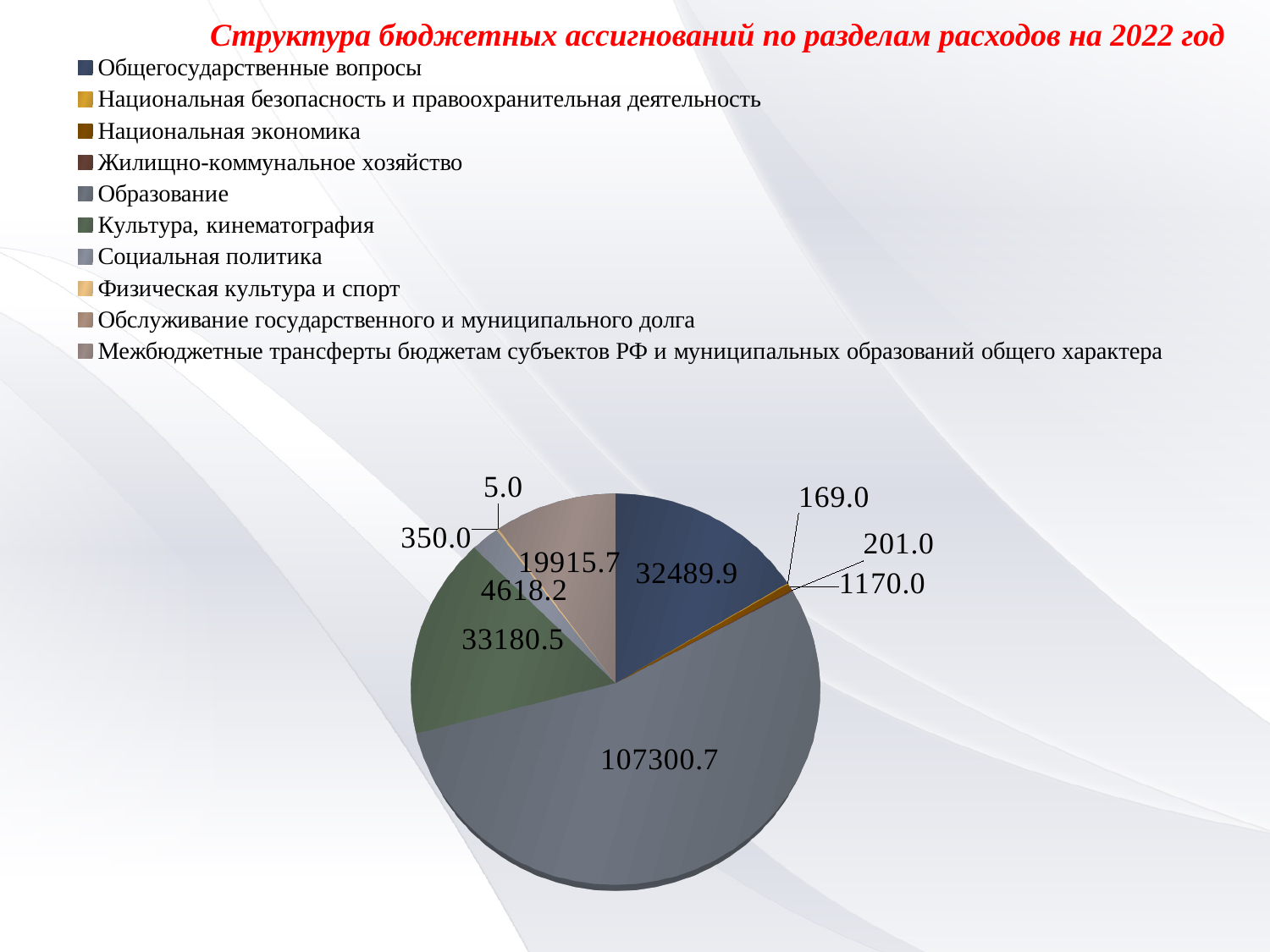
What is the value for Образование? 107300.7 Which category has the largest slice of the pie? Образование What kind of chart is shown on the slide? pie chart What is the smallest value labelled on the pie chart? 5.0 What is the value for Культура, кинематография? 33180.5 How many categories does the legend list? 10 What is the difference between the values for Культура, кинематография and Общегосударственные вопросы? 690.6 Which is larger, the value for Образование or the value for Культура, кинематография? Образование What is the title of the chart? Структура бюджетных ассигнований по разделам расходов на 2022 год What is the value for Общегосударственные вопросы? 32489.9 What is the value for Жилищно-коммунальное хозяйство? 201.0 How many data labels are shown on the pie chart? 10